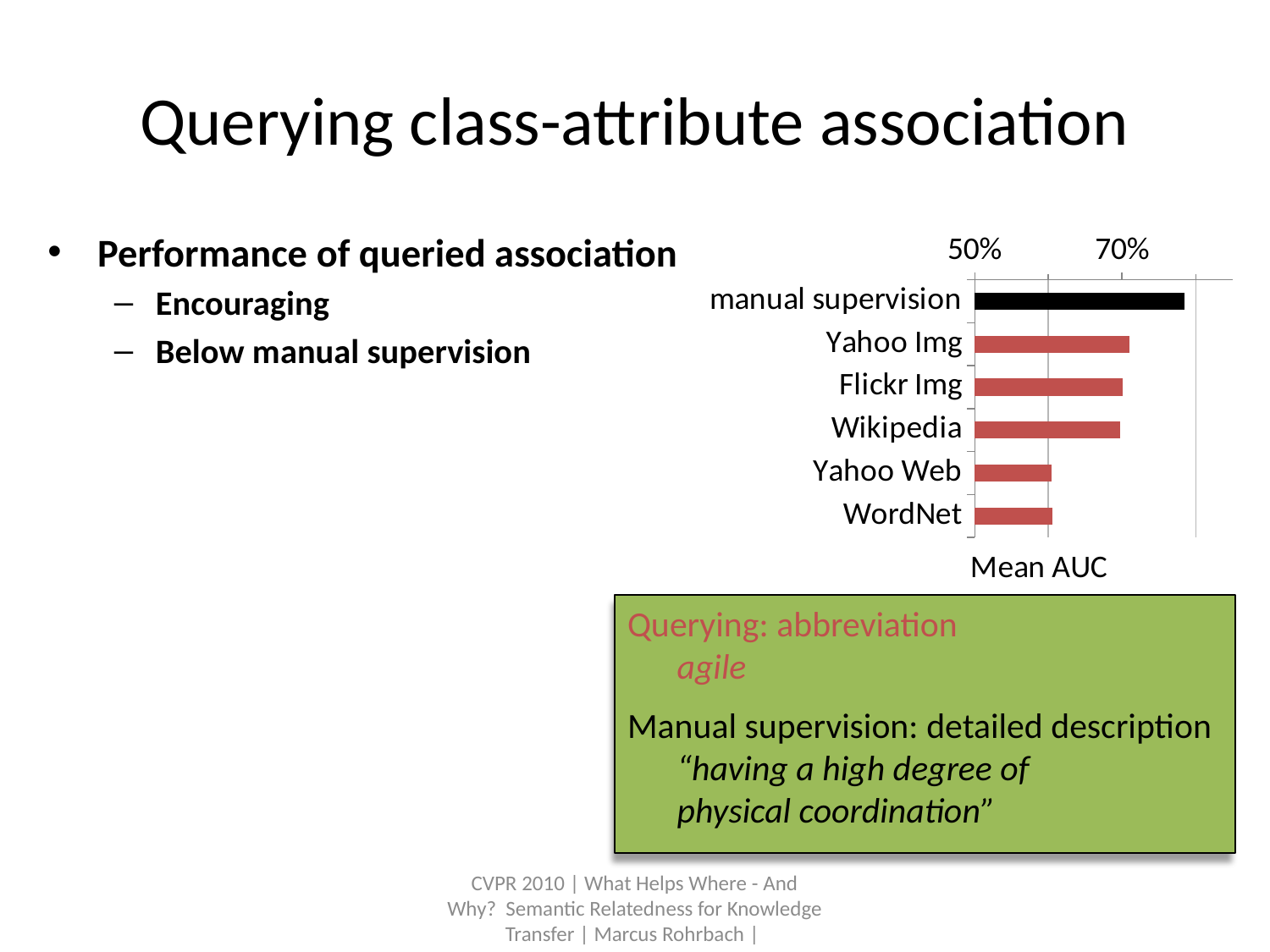
Is the value for Yahoo Web greater or less than 70%? less How many categories are plotted in the chart? 6 Which category has the highest Mean AUC in the chart? manual supervision What is the label of the value axis in the chart? Mean AUC Is the value for Yahoo Web greater or less than 50%? greater Which category's bar is drawn in black rather than red? manual supervision Is the value for WordNet greater or less than 70%? less What kind of chart is shown on the slide? bar chart Which has the larger Mean AUC, Wikipedia or Yahoo Web? Wikipedia Which has the larger Mean AUC, manual supervision or Yahoo Web? manual supervision Which has the larger Mean AUC, Yahoo Img or WordNet? Yahoo Img